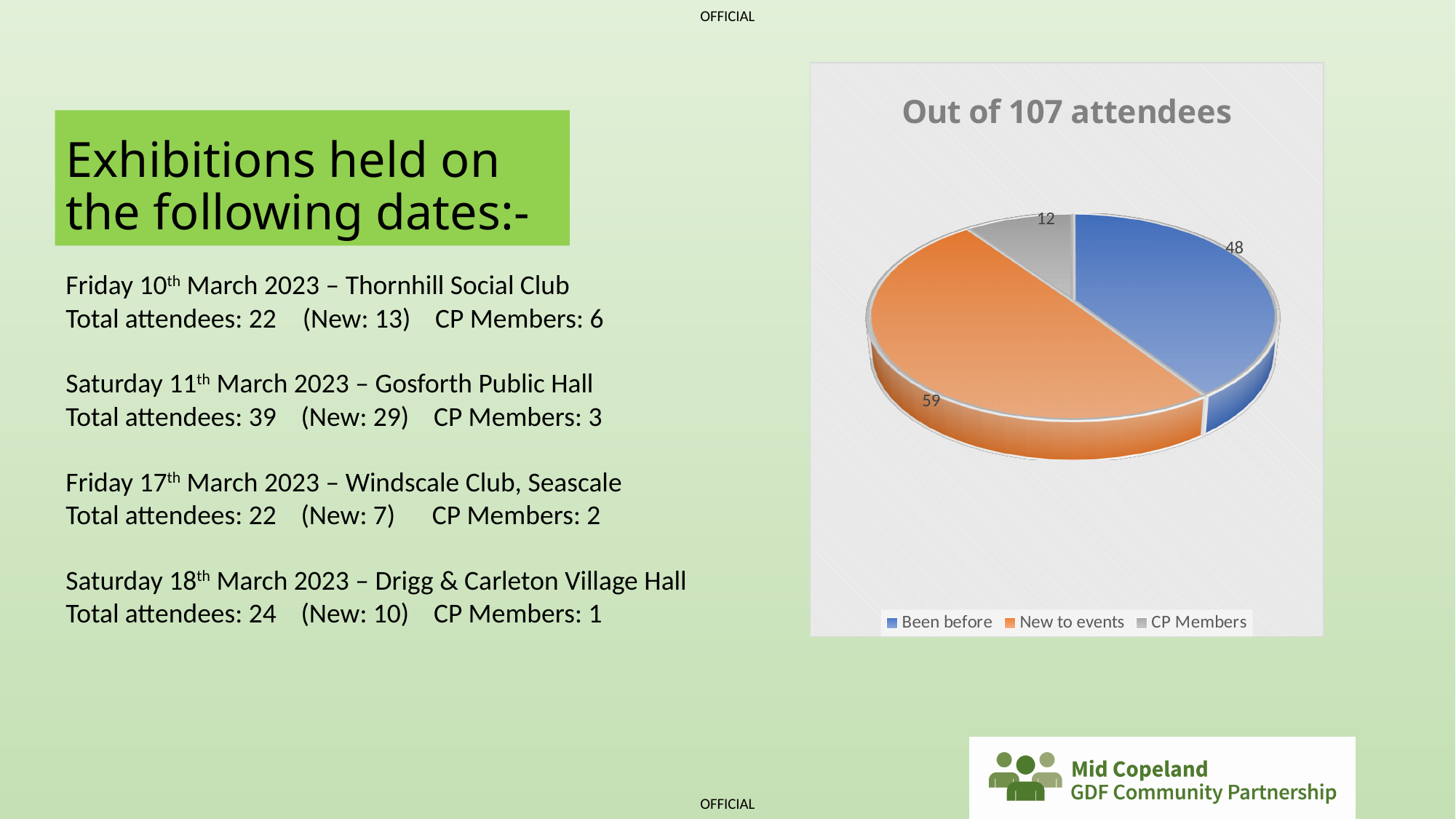
Which colour represents 'New to events' in the pie chart? orange Which category has the largest slice in the pie chart? New to events What is the difference between the 'New to events' and 'Been before' values in the pie chart? 11 What is the value for 'CP Members' in the pie chart? 12 What is the title of the pie chart? Out of 107 attendees What kind of chart is shown on the slide? pie chart What is the value for 'Been before' in the pie chart? 48 Which is larger in the pie chart, 'Been before' or 'CP Members'? Been before How many entries does the pie chart's legend list? 3 What is the value for 'New to events' in the pie chart? 59 How many slices does the pie chart have? 3 Which category has the smallest slice in the pie chart? CP Members